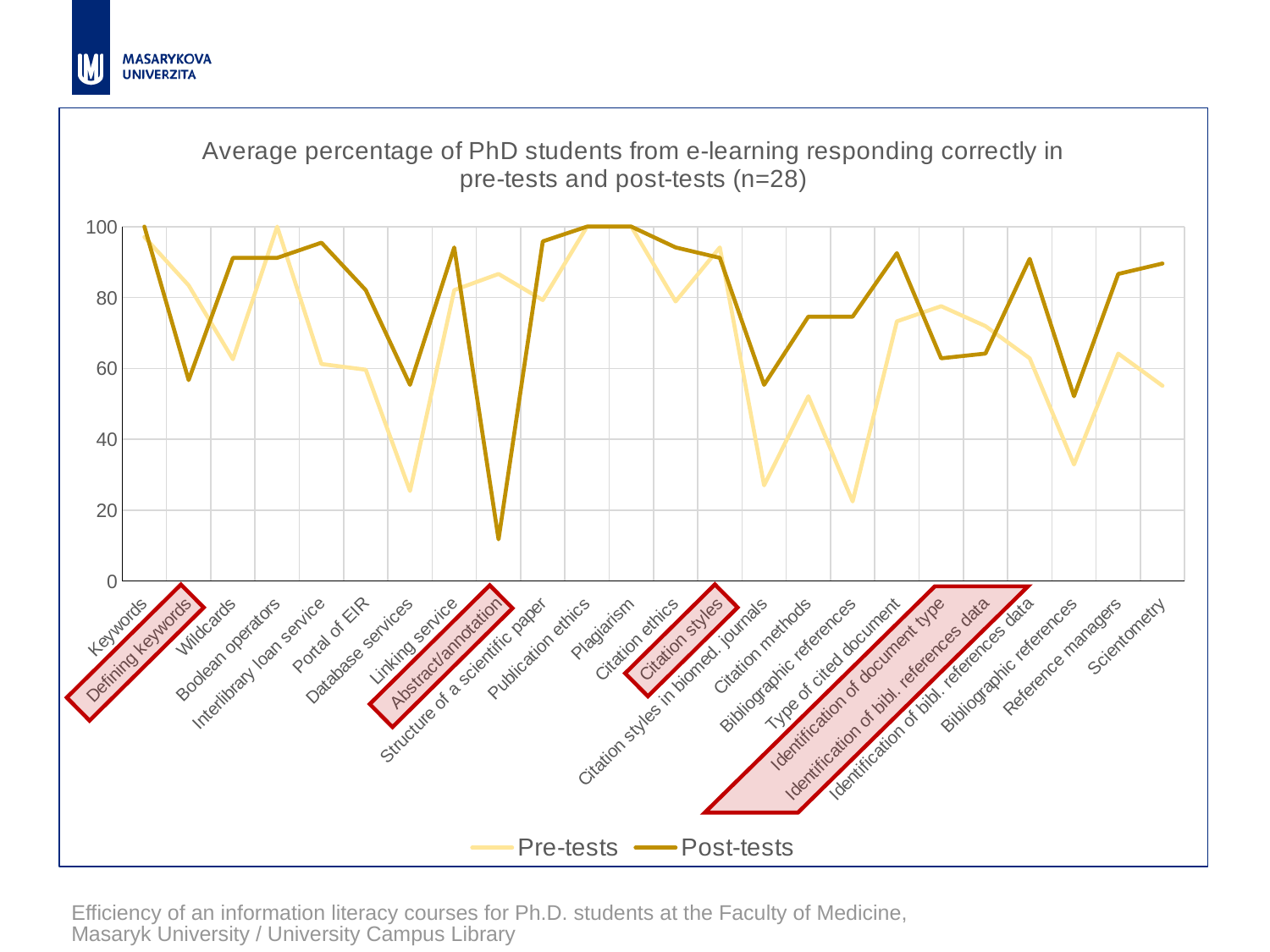
Is the Post-tests value for Abstract/annotation greater or less than 20? less What is the title of the chart? Average percentage of PhD students from e-learning responding correctly in pre-tests and post-tests (n=28) What is the Post-tests value for Publication ethics? 100 What kind of chart is shown on the slide? Line chart What is the Post-tests value for Plagiarism? 100 Which category has the lowest Post-tests value? Abstract/annotation Is the Post-tests value for Type of cited document greater or less than 80? greater For Abstract/annotation, which is larger: the Pre-tests value or the Post-tests value? Pre-tests How many series does the legend list? 2 How many categories are plotted along the x axis? 24 Is the Pre-tests value for Database services greater or less than 40? less